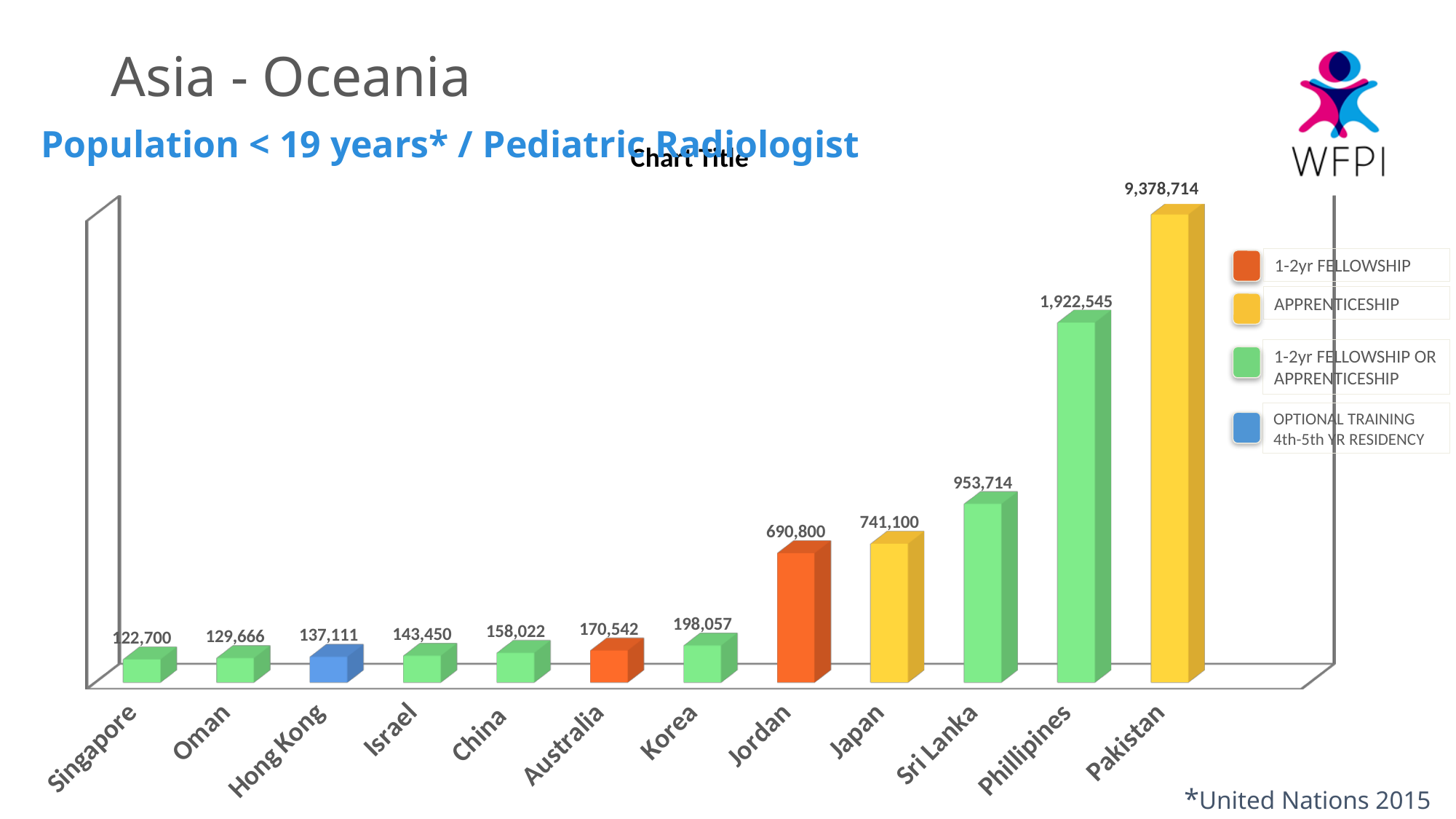
What is the value for Pakistan? 9,378,714 Which country has the highest value? Pakistan Which is larger, the value for Sri Lanka or the value for Japan? Sri Lanka What is the value for Jordan? 690,800 Which country has the lowest value? Singapore Which legend category does the bar for Hong Kong belong to? OPTIONAL TRAINING 4th-5th YR RESIDENCY What kind of chart is shown on the slide? Bar chart How many countries are shown on the chart? 12 What is the difference between the values for Pakistan and Phillipines? 7,456,169 What is the difference between the values for Japan and Jordan? 50,300 What is the value for Hong Kong? 137,111 How many entries does the legend list? 4